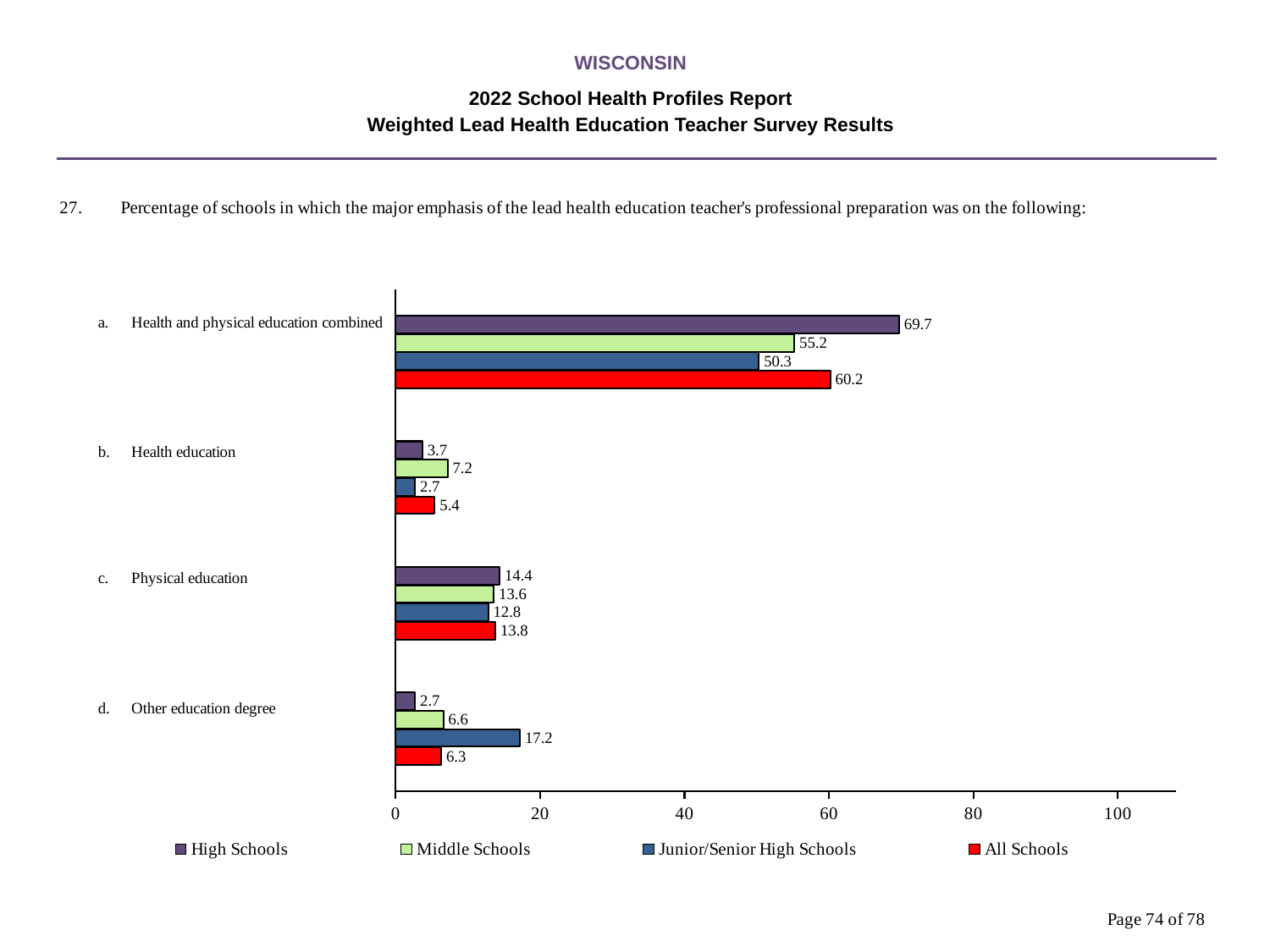
What is the value for Middle Schools for Physical education? 13.6 How many series does the legend list? 4 Is the All Schools value for Health and physical education combined greater or less than 40? greater Which is larger for Other education degree: the Middle Schools value or the Junior/Senior High Schools value? Junior/Senior High Schools What is the value for High Schools for Health and physical education combined? 69.7 What kind of chart is shown on the slide? bar chart How many categories are shown on the chart? 4 What is the value for All Schools for Health education? 5.4 What is the value for Junior/Senior High Schools for Other education degree? 17.2 Which category has the lowest value for High Schools? Other education degree What is the difference between the High Schools and Middle Schools values for Health and physical education combined? 14.5 Which category has the highest value for All Schools? Health and physical education combined